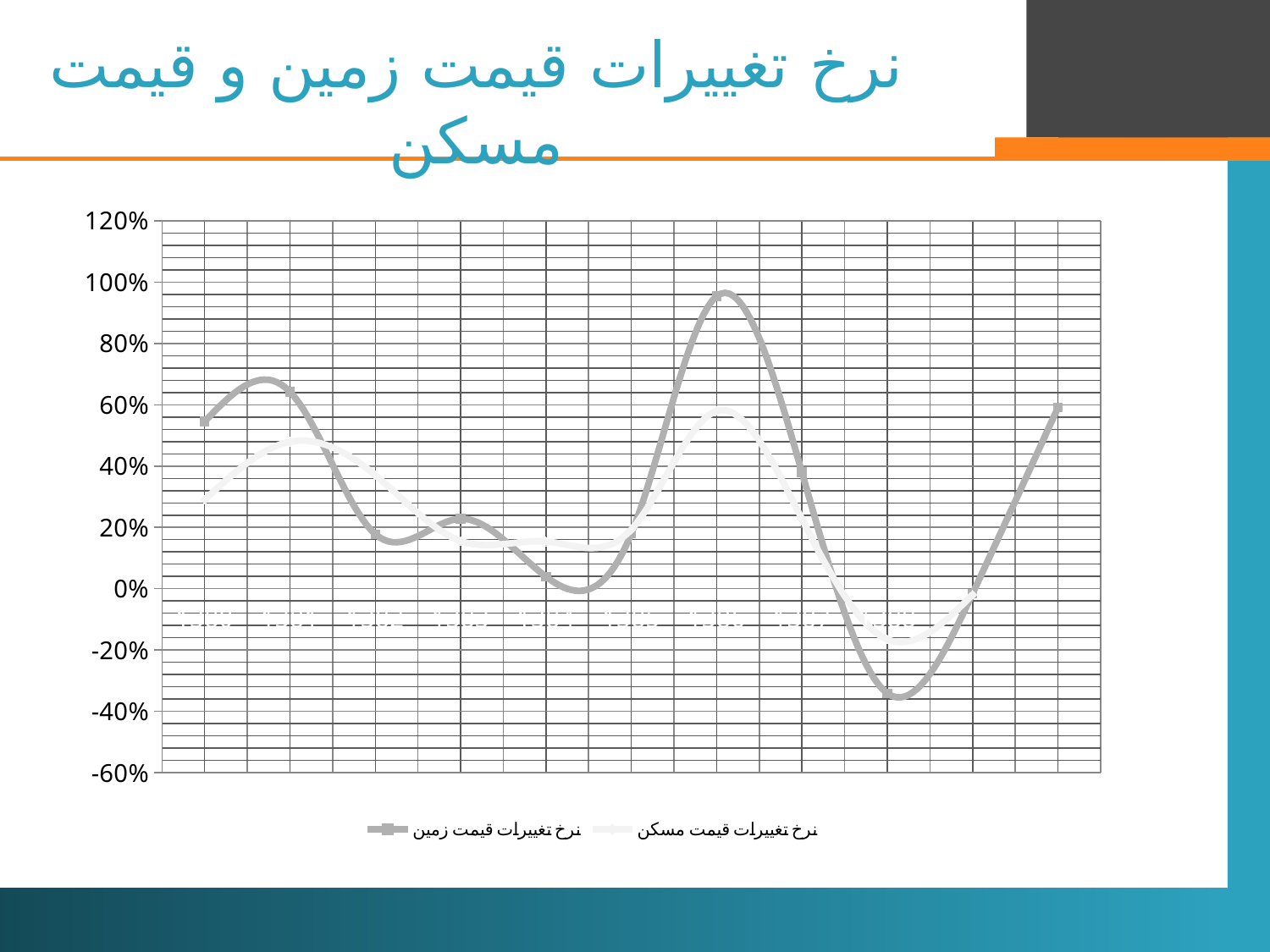
What kind of chart is shown on the slide? line chart Over the last three points of the chart, do the values of the نرخ تغییرات قیمت زمین series rise or fall? rise How many series does the legend list? 2 Which series drops to the lower minimum value, نرخ تغییرات قیمت زمین or نرخ تغییرات قیمت مسکن? نرخ تغییرات قیمت زمین Is the highest point of the نرخ تغییرات قیمت زمین series greater or less than 80%? greater Is the first point of the نرخ تغییرات قیمت زمین series greater or less than 40%? greater What is the highest value shown on the vertical axis? 120% Is the highest point of the نرخ تغییرات قیمت مسکن series greater or less than 80%? less What are the two series named in the legend? نرخ تغییرات قیمت زمین and نرخ تغییرات قیمت مسکن Which series reaches the higher peak value, نرخ تغییرات قیمت زمین or نرخ تغییرات قیمت مسکن? نرخ تغییرات قیمت زمین